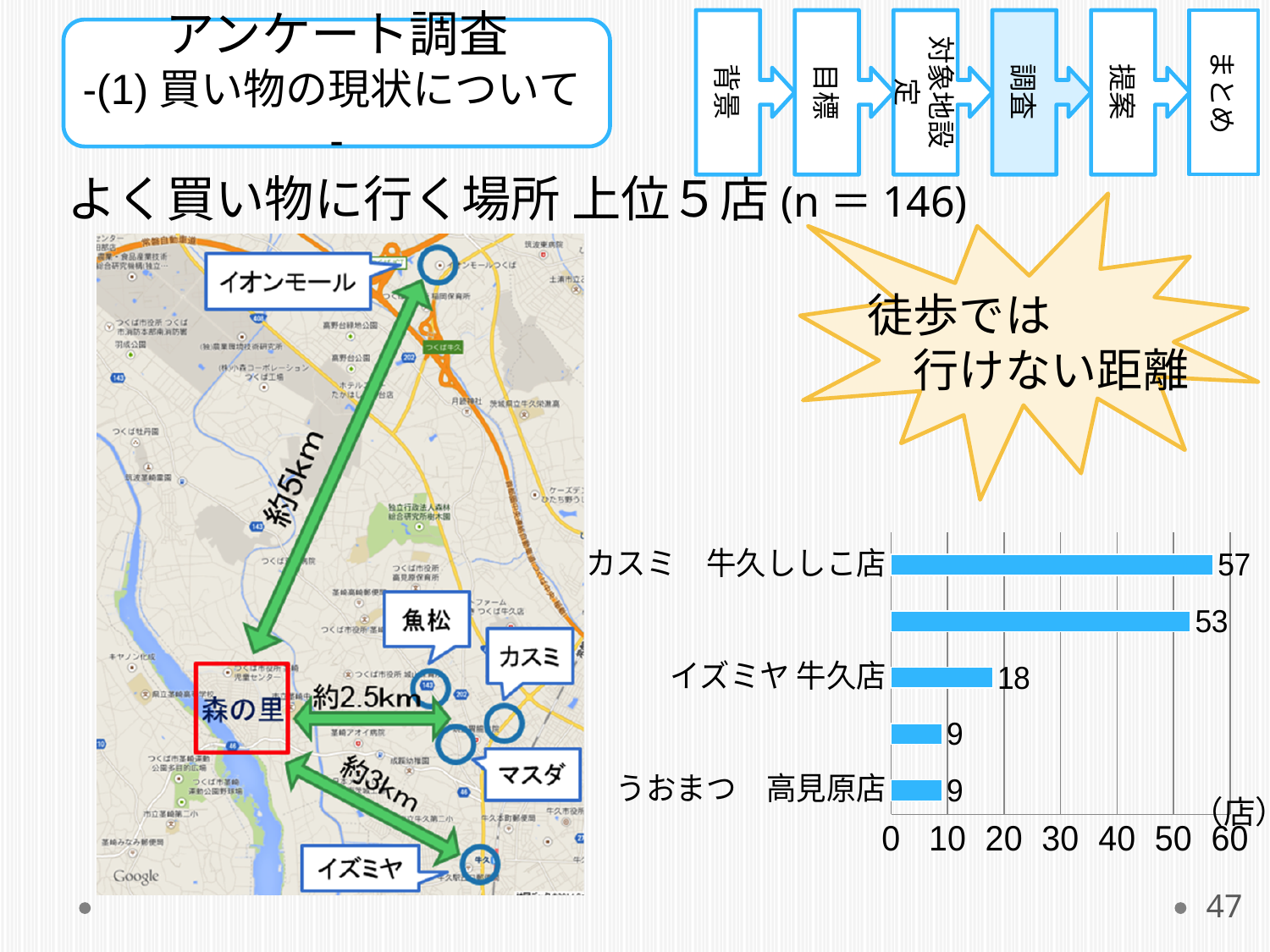
What is the sample size (n) stated in the heading above the chart? 146 What is the value for うおまつ 高見原店 in the bar chart? 9 What is the lowest value shown in the bar chart? 9 Which is larger, the value for イズミヤ 牛久店 or the value for うおまつ 高見原店? イズミヤ 牛久店 What is the difference between the values for イズミヤ 牛久店 and うおまつ 高見原店? 9 Is the value for カスミ 牛久ししこ店 greater or less than 50? greater What kind of chart is shown on the slide? bar chart How many bars are shown in the bar chart? 5 Which store has the highest value in the bar chart? カスミ 牛久ししこ店 What is the value for イズミヤ 牛久店 in the bar chart? 18 What is the value for カスミ 牛久ししこ店 in the bar chart? 57 What is the difference between the values for カスミ 牛久ししこ店 and イズミヤ 牛久店? 39